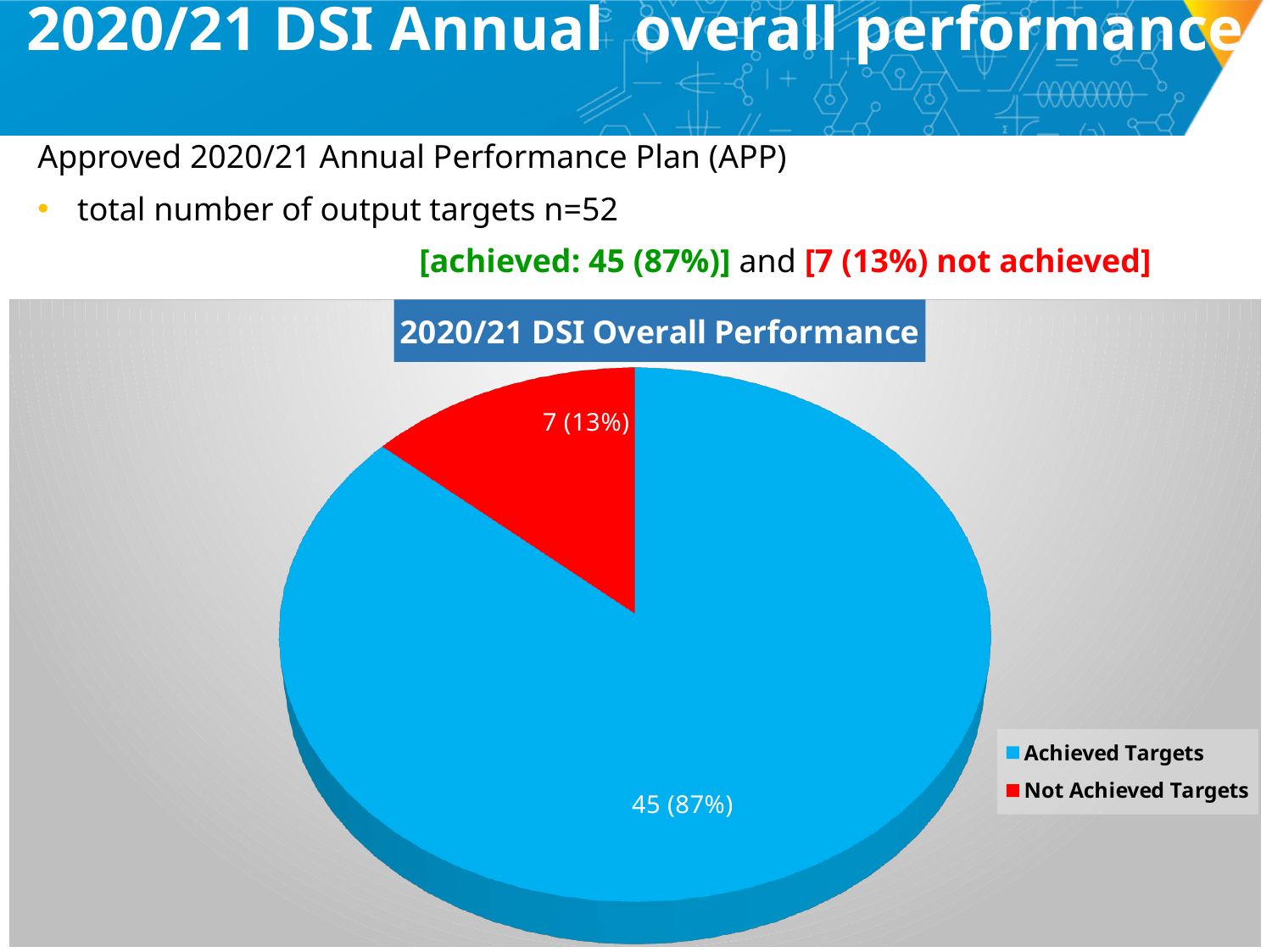
What kind of chart is shown on the slide? pie chart How many slices does the pie chart have? 2 What is the data label shown on the Achieved Targets slice? 45 (87%) Which slice is the smallest? Not Achieved Targets What share of the pie does the Achieved Targets slice represent? 87% What is the title of the chart? 2020/21 DSI Overall Performance Which slice is the largest? Achieved Targets What share of the pie does the Not Achieved Targets slice represent? 13% What colour is the Not Achieved Targets slice? red How many entries does the legend list? 2 What is the data label shown on the Not Achieved Targets slice? 7 (13%) What is the difference in the number of targets between Achieved Targets and Not Achieved Targets? 38